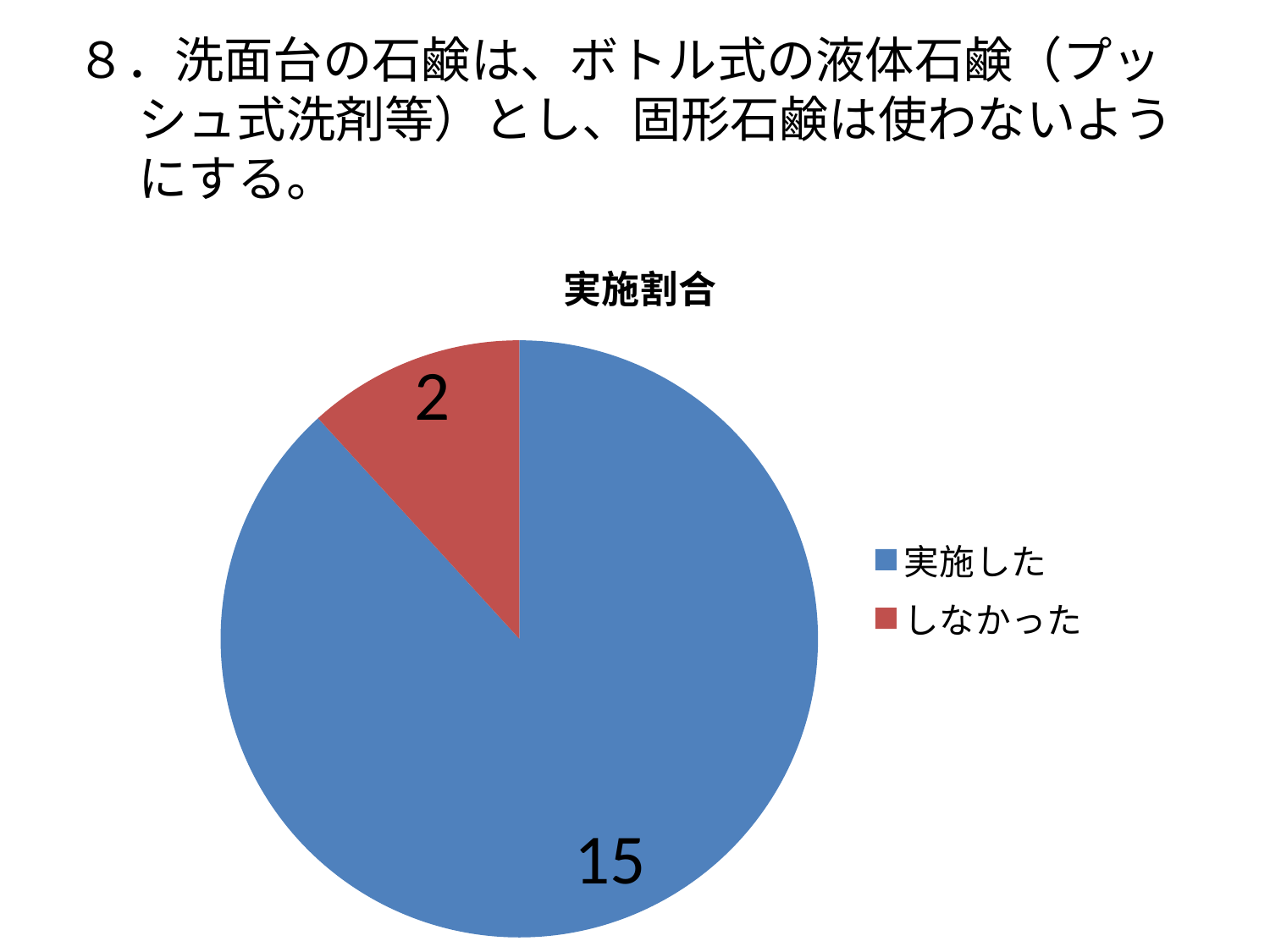
What type of chart is shown on the slide? pie chart Which category has the smallest slice? しなかった What is the value for しなかった? 2 How many slices does the pie chart have? 2 What colour is the slice for しなかった? red Which category has the largest slice? 実施した What is the value for 実施した? 15 What is the total of all slices in the pie chart? 17 Which is larger, the value for 実施した or the value for しなかった? 実施した What is the title of the chart? 実施割合 What is the difference between the values for 実施した and しなかった? 13 How many entries does the legend list? 2